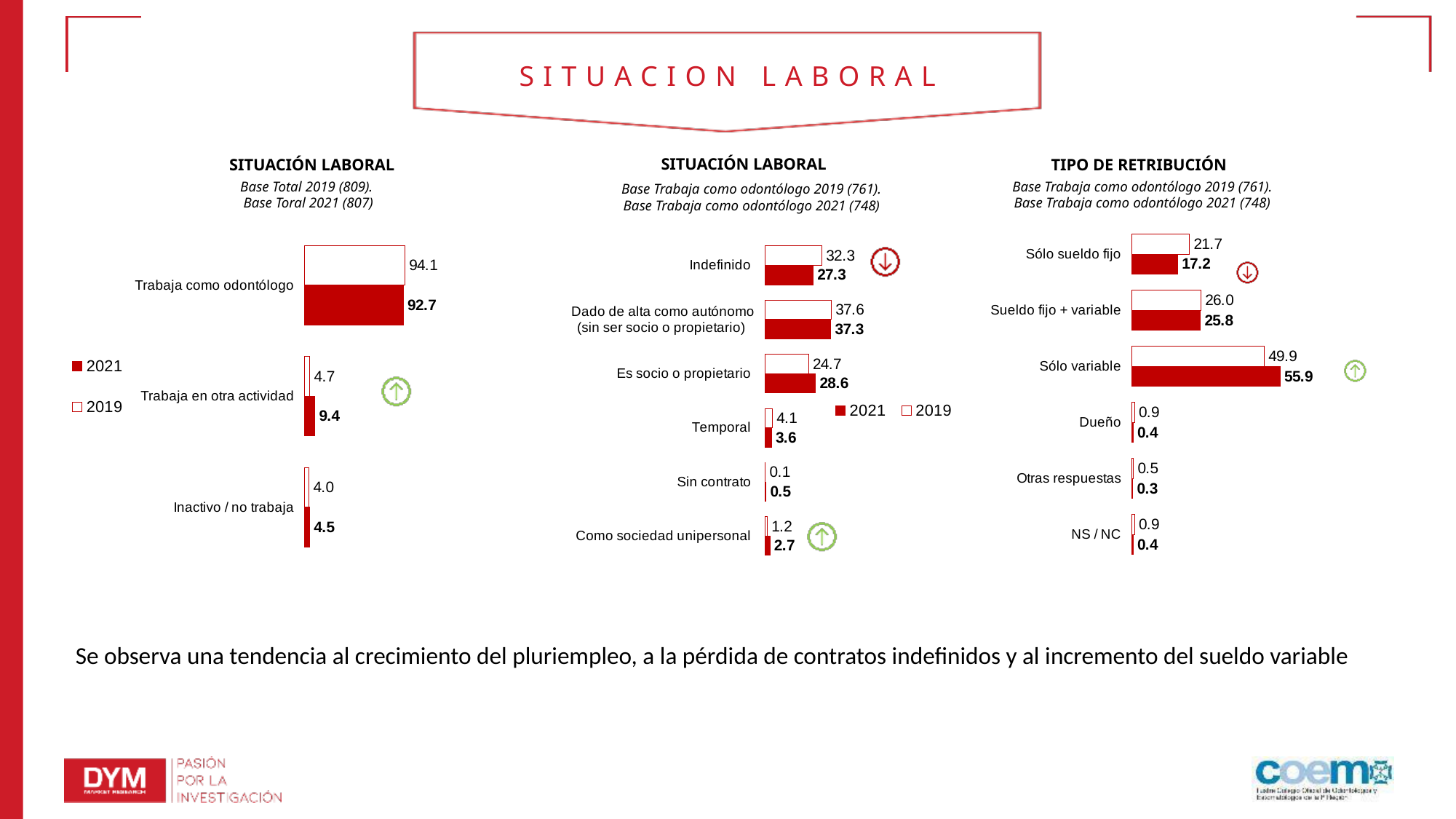
In the left chart (SITUACIÓN LABORAL, Base Total), what is the difference between the 2021 and 2019 values for 'Trabaja en otra actividad'? 4.7 How many series does the legend list in the left chart (SITUACIÓN LABORAL, Base Total)? 2 In the left chart (SITUACIÓN LABORAL, Base Total), what is the 2021 value for 'Trabaja como odontólogo'? 92.7 In the middle chart (SITUACIÓN LABORAL, Base Trabaja como odontólogo), which category has the highest 2021 value? Dado de alta como autónomo (sin ser socio o propietario) In the right chart (TIPO DE RETRIBUCIÓN), which is larger for 'Sólo sueldo fijo': the 2019 value or the 2021 value? 2019 In the middle chart (SITUACIÓN LABORAL, Base Trabaja como odontólogo), how many categories are shown? 6 In the right chart (TIPO DE RETRIBUCIÓN), what is the 2021 value for 'Sólo variable'? 55.9 In the middle chart (SITUACIÓN LABORAL, Base Trabaja como odontólogo), what is the 2021 value for 'Indefinido'? 27.3 In the left chart (SITUACIÓN LABORAL, Base Total), what is the 2019 value for 'Trabaja en otra actividad'? 4.7 In the middle chart (SITUACIÓN LABORAL, Base Trabaja como odontólogo), which category has the lowest 2019 value? Sin contrato In the right chart (TIPO DE RETRIBUCIÓN), what is the difference between the 2021 and 2019 values for 'Sólo variable'? 6.0 What type of chart is the right chart (TIPO DE RETRIBUCIÓN)? Bar chart